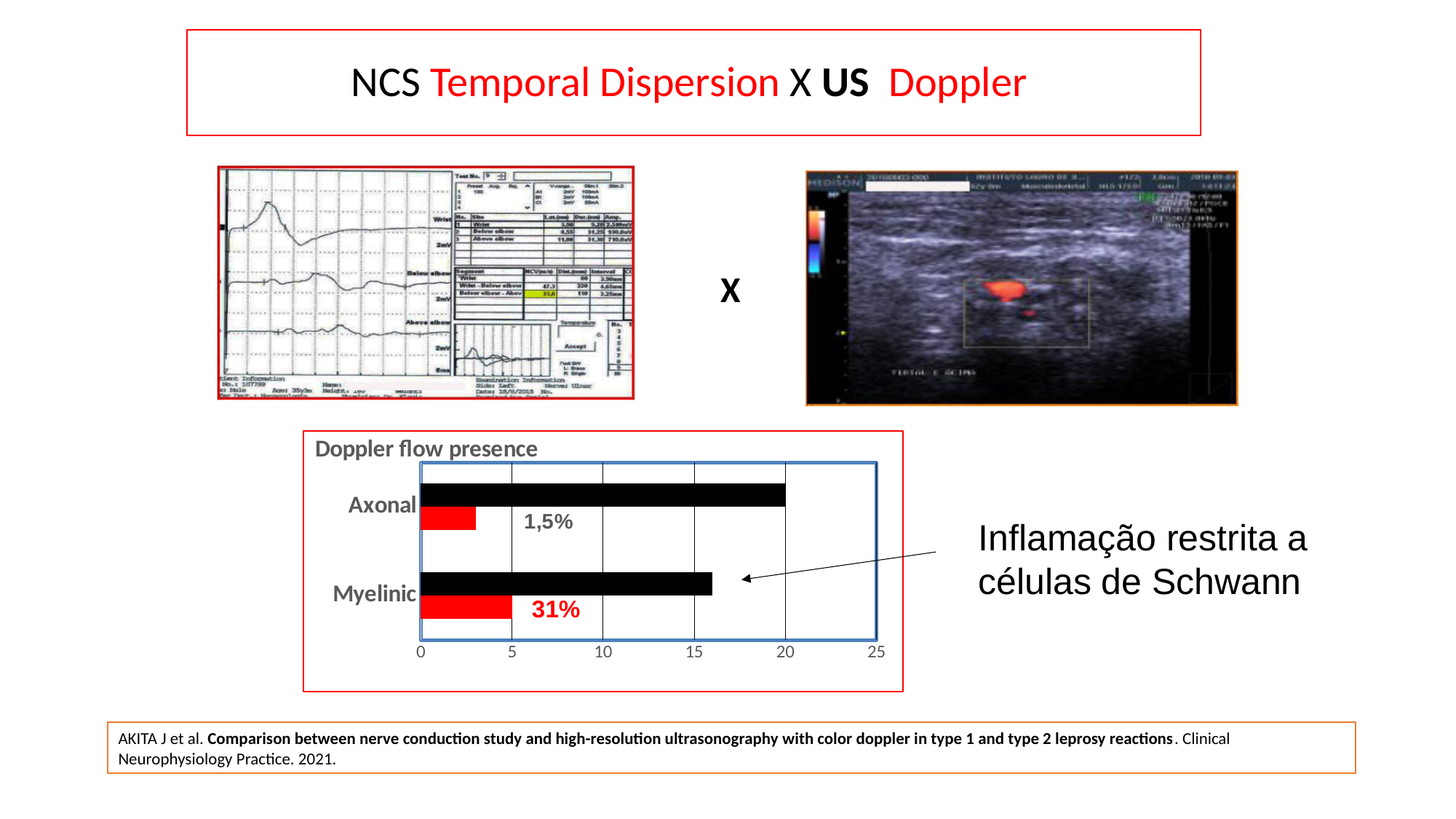
In the "Doppler flow presence" chart, is the black bar for Axonal greater or less than 15? greater What kind of chart is the "Doppler flow presence" chart? bar chart What is the highest value shown on the horizontal axis of the "Doppler flow presence" chart? 25 In the "Doppler flow presence" chart, which category has the longer red bar, Axonal or Myelinic? Myelinic What is the title of the chart on the slide? Doppler flow presence What data label is printed next to the red bar for Axonal in the "Doppler flow presence" chart? 1,5% In the "Doppler flow presence" chart, is the red bar for Axonal greater or less than 5? less In the "Doppler flow presence" chart, is the black bar for Myelinic greater or less than 10? greater In the "Doppler flow presence" chart, which category has the longer black bar, Axonal or Myelinic? Axonal How many categories are shown on the "Doppler flow presence" chart? 2 What data label is printed next to the red bar for Myelinic in the "Doppler flow presence" chart? 31%